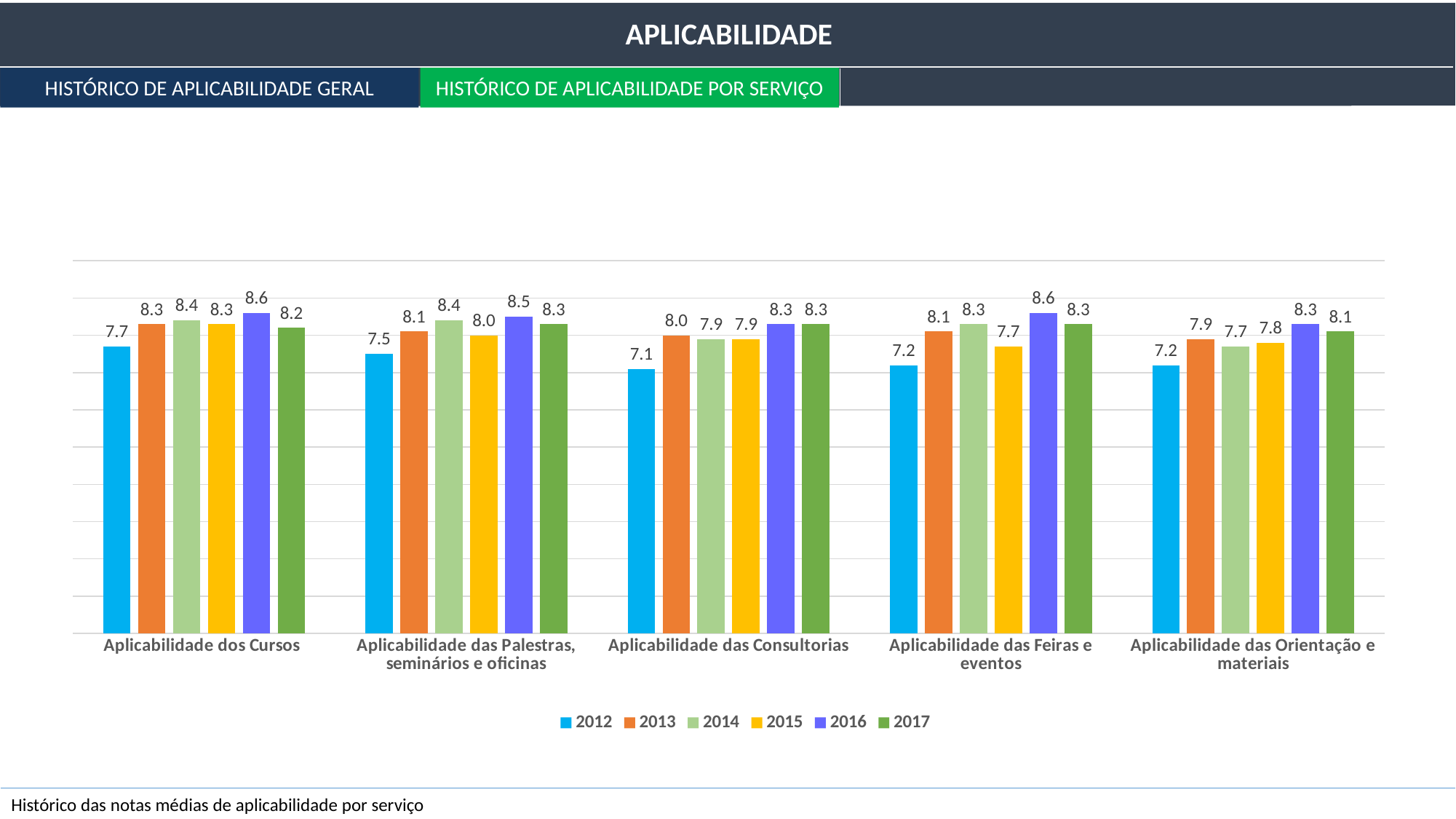
What is the value for 2012 in the "Aplicabilidade das Consultorias" category? 7.1 Which year has the highest value in the "Aplicabilidade das Palestras, seminários e oficinas" category? 2016 What is the difference between the 2016 and 2012 values in the "Aplicabilidade das Consultorias" category? 1.2 What is the value for 2014 in the "Aplicabilidade das Orientação e materiais" category? 7.7 What is the value for 2016 in the "Aplicabilidade dos Cursos" category? 8.6 What kind of chart is shown on the slide? Bar chart How many service categories are shown on the x axis? 5 Which year is represented by the yellow bars in the legend? 2015 How many series does the legend list? 6 What is the value for 2015 in the "Aplicabilidade das Feiras e eventos" category? 7.7 Which year has the lowest value in the "Aplicabilidade das Feiras e eventos" category? 2012 Which is larger in the "Aplicabilidade dos Cursos" category: the 2013 value or the 2017 value? 2013